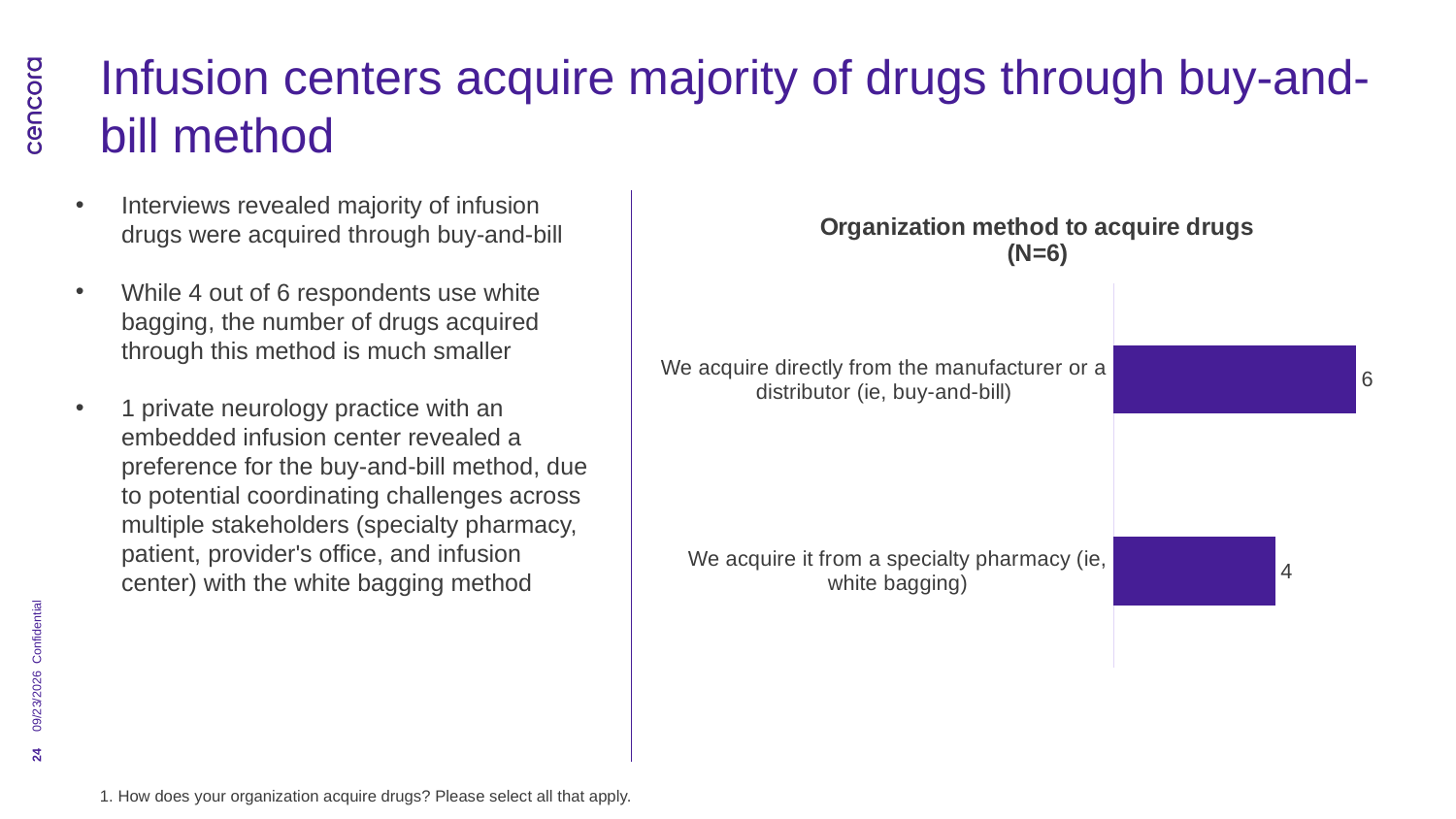
What is the sample size (N) stated in the chart title? 6 What is the difference between the buy-and-bill value and the white bagging value? 2 What is the title of the chart? Organization method to acquire drugs (N=6) What is the value for 'We acquire it from a specialty pharmacy (ie, white bagging)'? 4 How many categories are shown in the chart? 2 Which is larger: the value for buy-and-bill or the value for white bagging? Buy-and-bill Which category has the highest value? We acquire directly from the manufacturer or a distributor (ie, buy-and-bill) Which category has the lowest value? We acquire it from a specialty pharmacy (ie, white bagging) What kind of chart is shown on the slide? Bar chart What is the value for 'We acquire directly from the manufacturer or a distributor (ie, buy-and-bill)'? 6